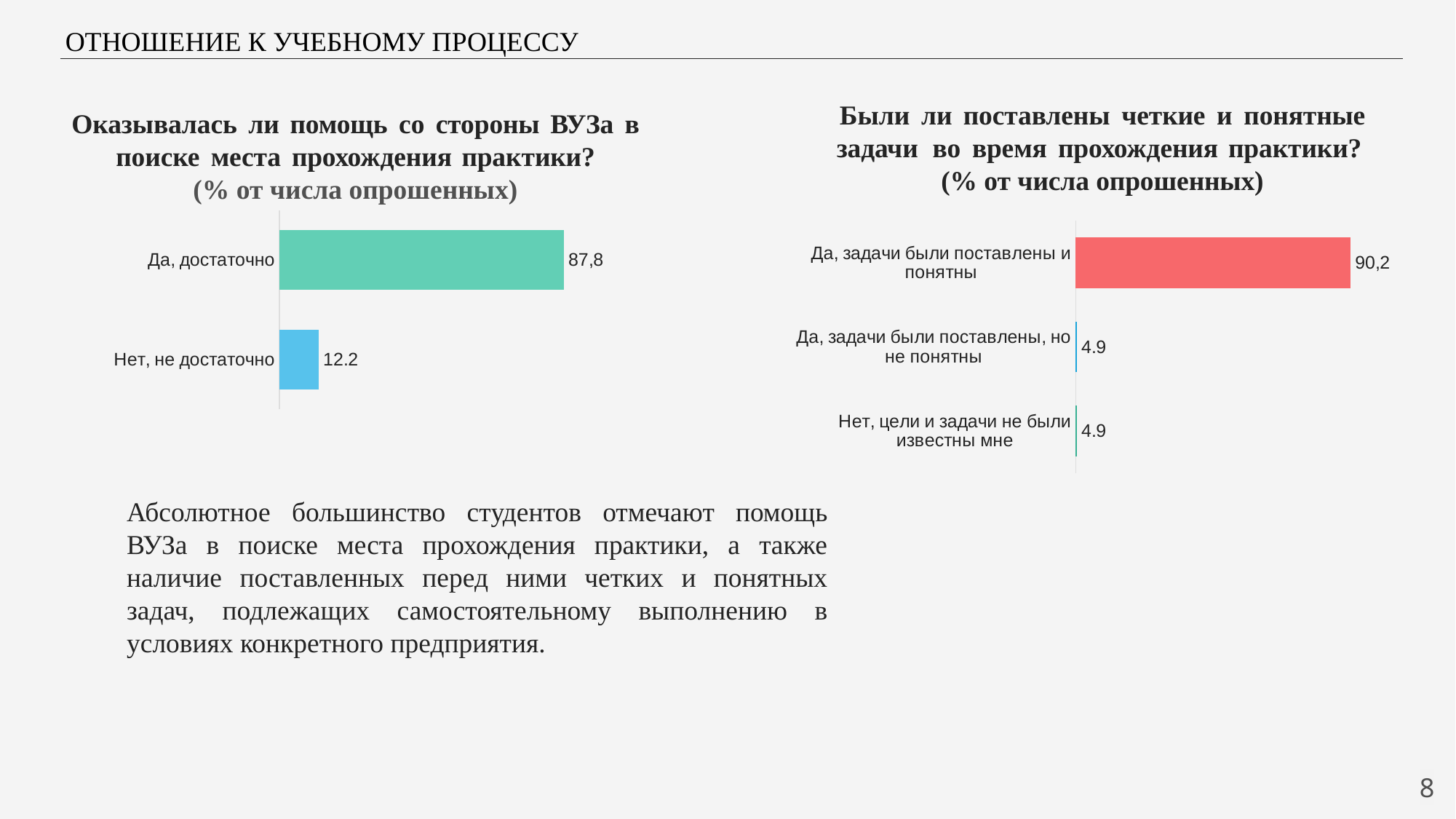
In the right chart (Были ли поставлены четкие и понятные задачи во время прохождения практики?), what is the value for "Да, задачи были поставлены и понятны"? 90,2 In the left chart (Оказывалась ли помощь со стороны ВУЗа в поиске места прохождения практики?), what is the value for "Да, достаточно"? 87,8 In the right chart (Были ли поставлены четкие и понятные задачи во время прохождения практики?), which category has the highest value? Да, задачи были поставлены и понятны In the right chart (Были ли поставлены четкие и понятные задачи во время прохождения практики?), what is the difference between "Да, задачи были поставлены и понятны" and "Да, задачи были поставлены, но не понятны"? 85.3 In the right chart (Были ли поставлены четкие и понятные задачи во время прохождения практики?), what colour is the bar for "Да, задачи были поставлены и понятны"? Red In the left chart (Оказывалась ли помощь со стороны ВУЗа в поиске места прохождения практики?), what is the difference between "Да, достаточно" and "Нет, не достаточно"? 75.6 In the left chart (Оказывалась ли помощь со стороны ВУЗа в поиске места прохождения практики?), what is the value for "Нет, не достаточно"? 12.2 In the left chart (Оказывалась ли помощь со стороны ВУЗа в поиске места прохождения практики?), which category has the highest value? Да, достаточно In the left chart (Оказывалась ли помощь со стороны ВУЗа в поиске места прохождения практики?), how many categories are shown? 2 In the right chart (Были ли поставлены четкие и понятные задачи во время прохождения практики?), how many categories are shown? 3 What type of chart is the left chart (Оказывалась ли помощь со стороны ВУЗа в поиске места прохождения практики?)? Bar chart In the right chart (Были ли поставлены четкие и понятные задачи во время прохождения практики?), what is the value for "Нет, цели и задачи не были известны мне"? 4.9